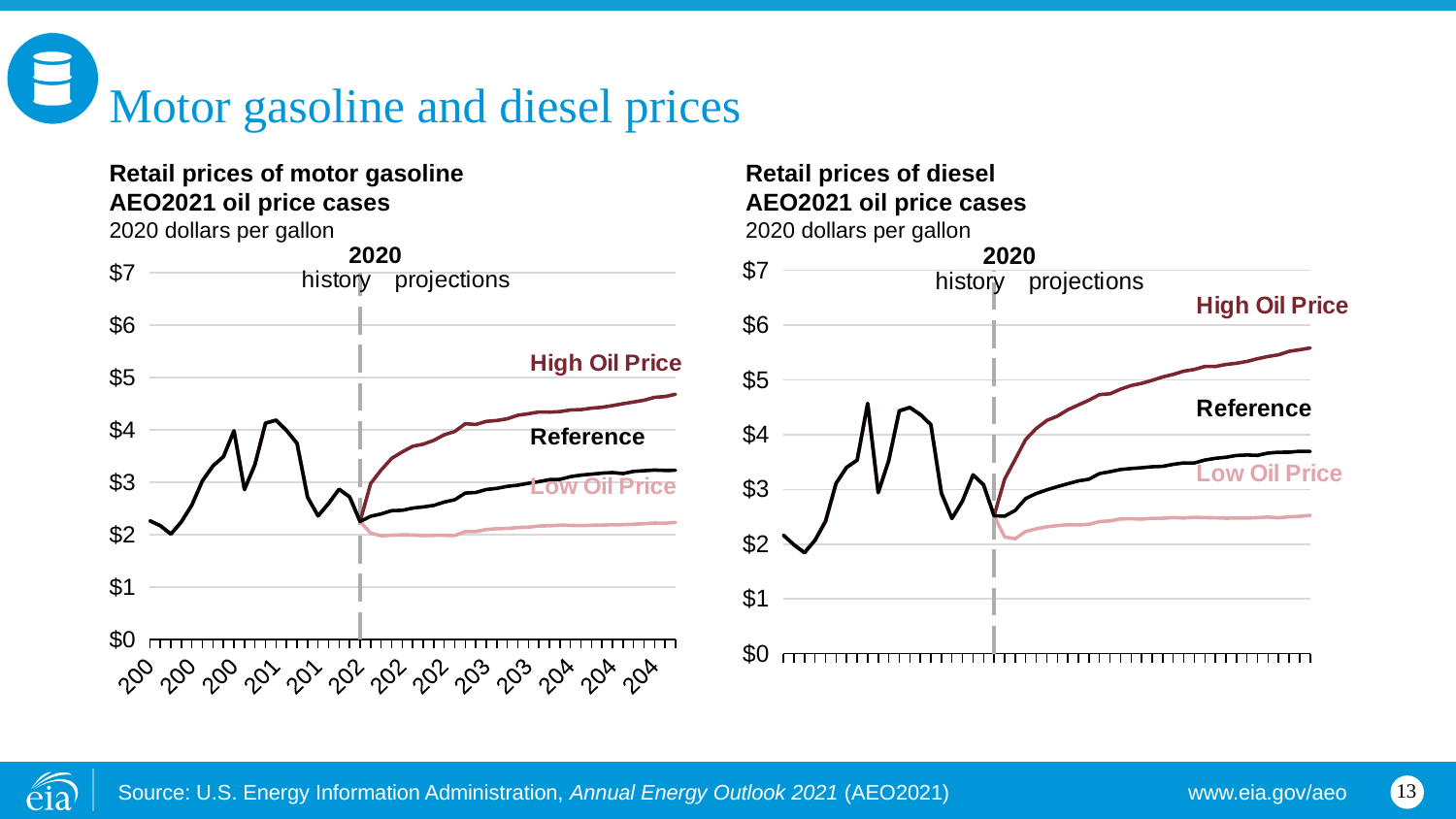
How many price cases (series) are plotted on the 'Retail prices of diesel' chart? 3 On the 'Retail prices of motor gasoline' chart, is the High Oil Price value at the end of the projection period greater or less than $4? greater What kind of chart is the 'Retail prices of motor gasoline' chart? line chart On the 'Retail prices of motor gasoline' chart, which case is higher at the end of the projection period, High Oil Price or Reference? High Oil Price On the 'Retail prices of diesel' chart, which case is lowest at the end of the projection period? Low Oil Price On the 'Retail prices of diesel' chart, which year marks the boundary between history and projections? 2020 On the 'Retail prices of diesel' chart, is the High Oil Price value at the end of the projection period greater or less than $5? greater What unit are prices shown in on the 'Retail prices of motor gasoline' chart? 2020 dollars per gallon On the 'Retail prices of motor gasoline' chart, is the Low Oil Price value at the end of the projection period greater or less than $3? less On the 'Retail prices of diesel' chart, does the High Oil Price line rise or fall over the projection period? rise